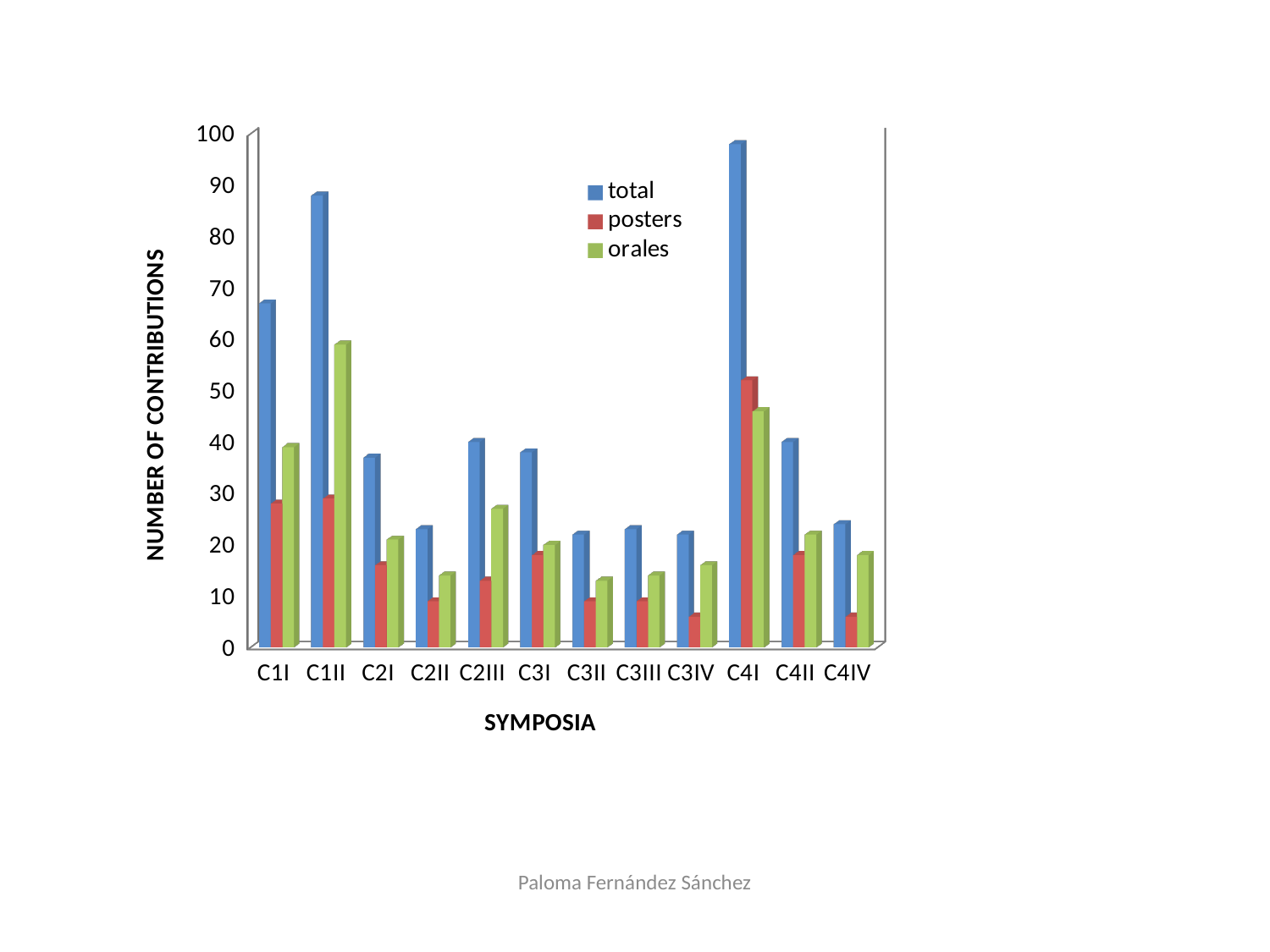
For C4I, which is larger: posters or orales? posters What is the label of the y axis? NUMBER OF CONTRIBUTIONS Is the posters value for C3IV greater or less than 10? less How many symposia categories are shown on the x axis? 12 Which symposium has the highest total number of contributions? C4I Which symposium has the highest number of orales? C1II Is the total value for C1II greater or less than 80? greater Is the total value for C4I greater or less than 90? greater What kind of chart is shown on the slide? bar chart Which symposium has the highest number of posters? C4I How many series does the legend list? 3